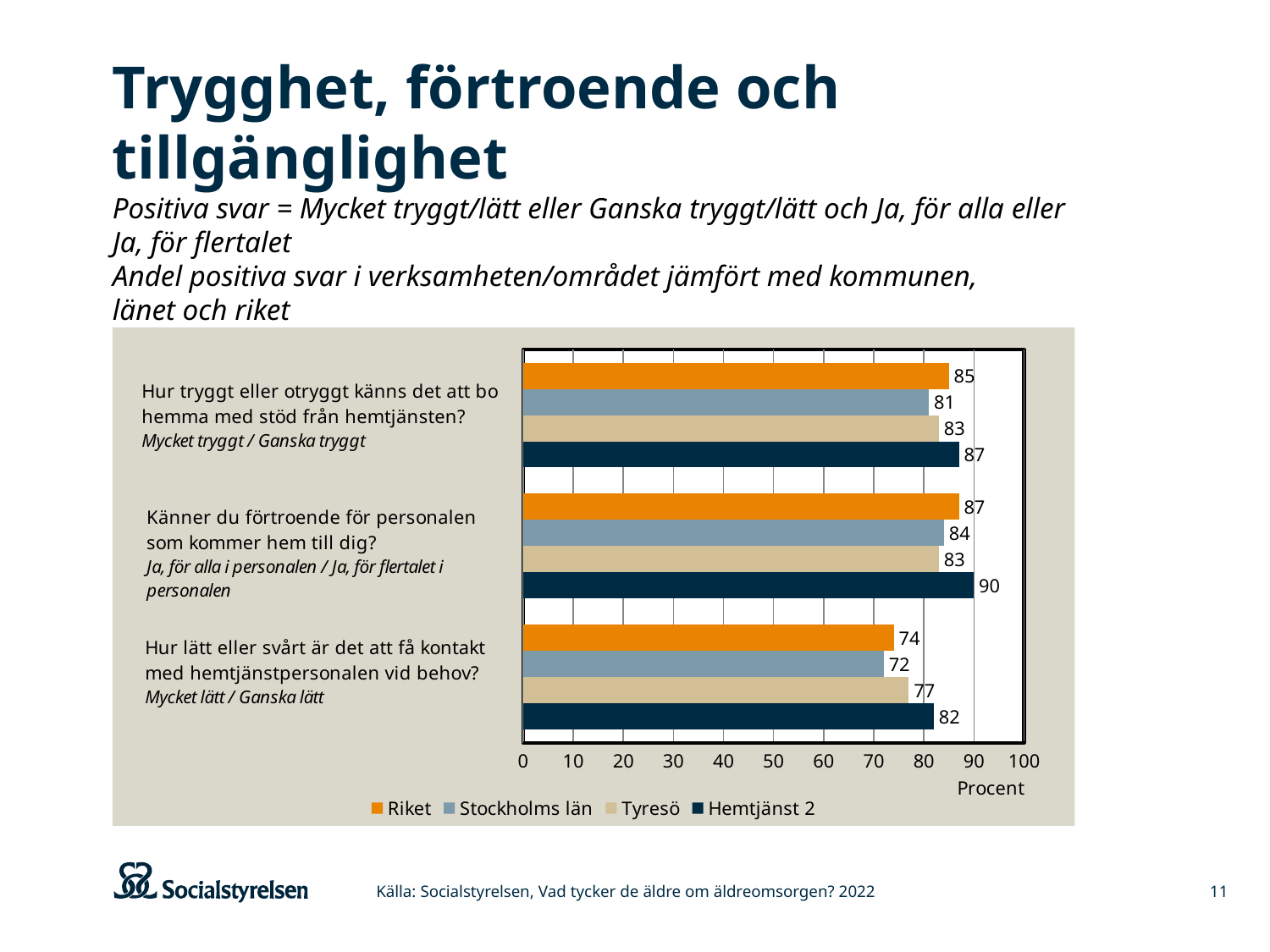
Is the value for Stockholms län on the question 'Hur lätt eller svårt är det att få kontakt med hemtjänstpersonalen vid behov?' greater or less than 80? less What is the value for Tyresö on the question 'Hur tryggt eller otryggt känns det att bo hemma med stöd från hemtjänsten?' 83 How many question categories are plotted on the chart? 3 What kind of chart is shown on the slide? bar chart Which series has the lowest value on the question 'Hur tryggt eller otryggt känns det att bo hemma med stöd från hemtjänsten?' Stockholms län What unit label is shown under the x axis of the chart? Procent What is the value for Stockholms län on the question 'Hur lätt eller svårt är det att få kontakt med hemtjänstpersonalen vid behov?' 72 How many series does the legend list? 4 What is the difference between Hemtjänst 2 and Riket on the question 'Hur lätt eller svårt är det att få kontakt med hemtjänstpersonalen vid behov?' 8 What is the value for Hemtjänst 2 on the question 'Känner du förtroende för personalen som kommer hem till dig?' 90 Which is larger on the question 'Känner du förtroende för personalen som kommer hem till dig?': Riket or Tyresö? Riket Which series has the highest value on the question 'Hur lätt eller svårt är det att få kontakt med hemtjänstpersonalen vid behov?' Hemtjänst 2